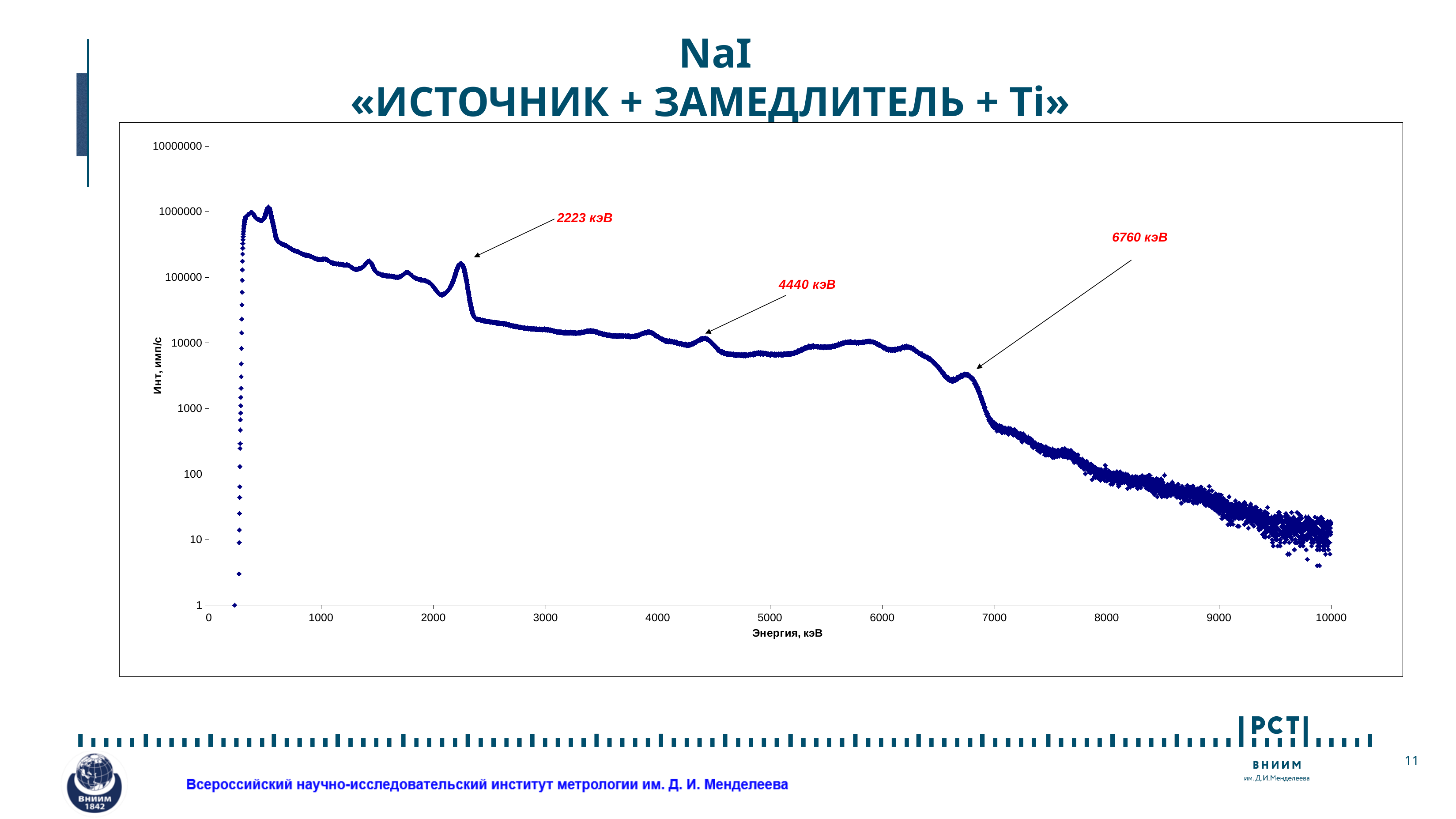
What energy is annotated at the peak near 2200 on the x axis? 2223 кэВ What energy is annotated at the peak near 4400 on the x axis? 4440 кэВ What is the label of the y axis? Инт, имп/с Overall, do the plotted values rise or fall as energy increases from 1000 to 10000 кэВ? fall What is the label of the x axis? Энергия, кэВ Is the plotted value at 1000 кэВ greater or less than 100000? greater Which annotated peak has the highest energy? 6760 кэВ Is the plotted value at 3000 кэВ greater or less than 10000? greater Is the plotted value at 9000 кэВ greater or less than 100? less How many peaks are annotated with energy labels on the chart? 3 Which annotated peak has the lowest energy? 2223 кэВ What kind of chart is shown on the slide? scatter chart